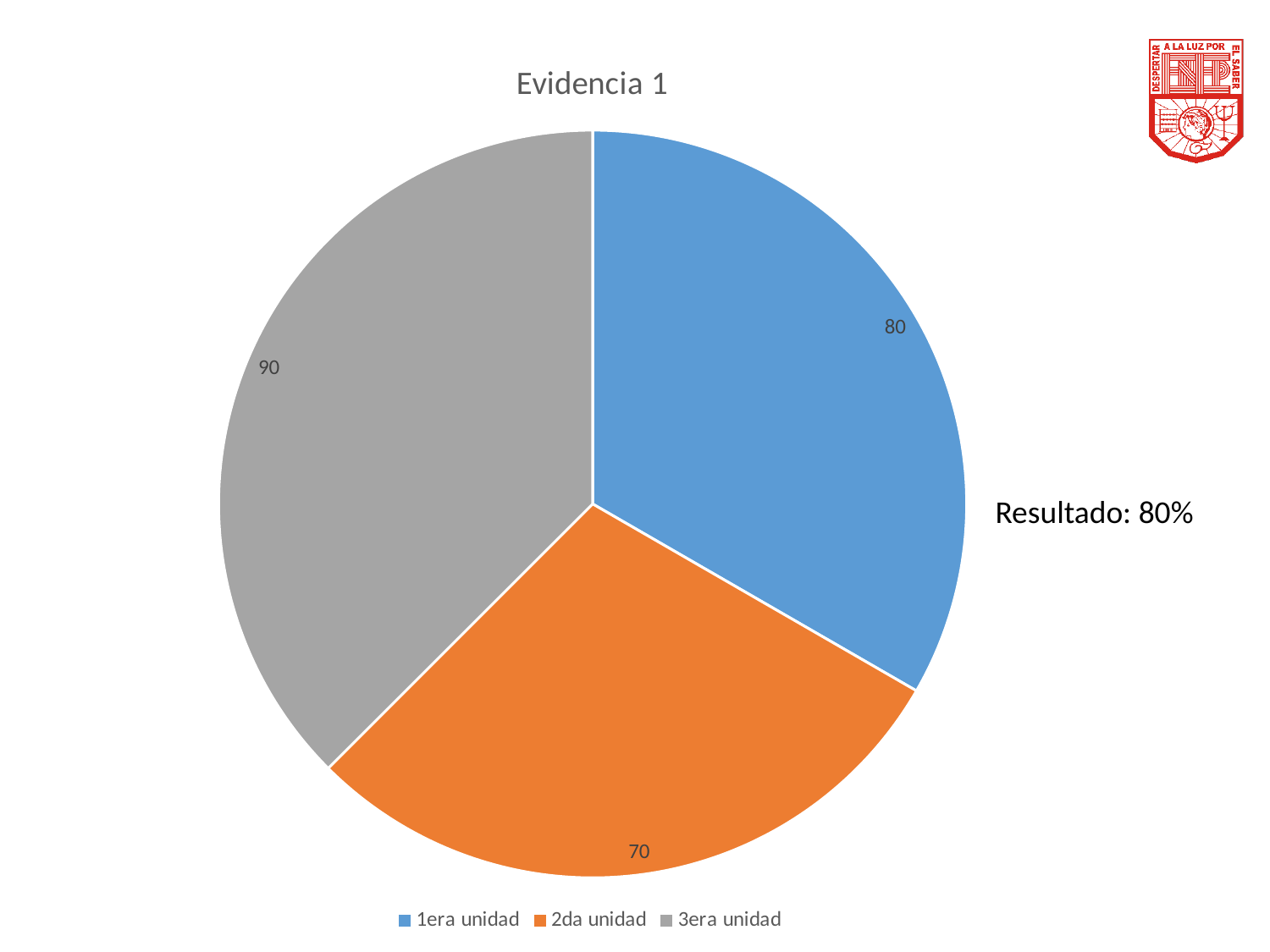
Which unit has the largest slice? 3era unidad Which colour represents 2da unidad in the legend? orange What is the difference between the values for 3era unidad and 2da unidad? 20 What share of the pie does 3era unidad represent? 37.5% What is the title of the chart? Evidencia 1 Which is larger, the value for 1era unidad or 2da unidad? 1era unidad What is the value for 1era unidad? 80 How many slices does the pie chart have? 3 What is the value for 3era unidad? 90 What is the value for 2da unidad? 70 Which unit has the smallest slice? 2da unidad What kind of chart is shown on the slide? pie chart